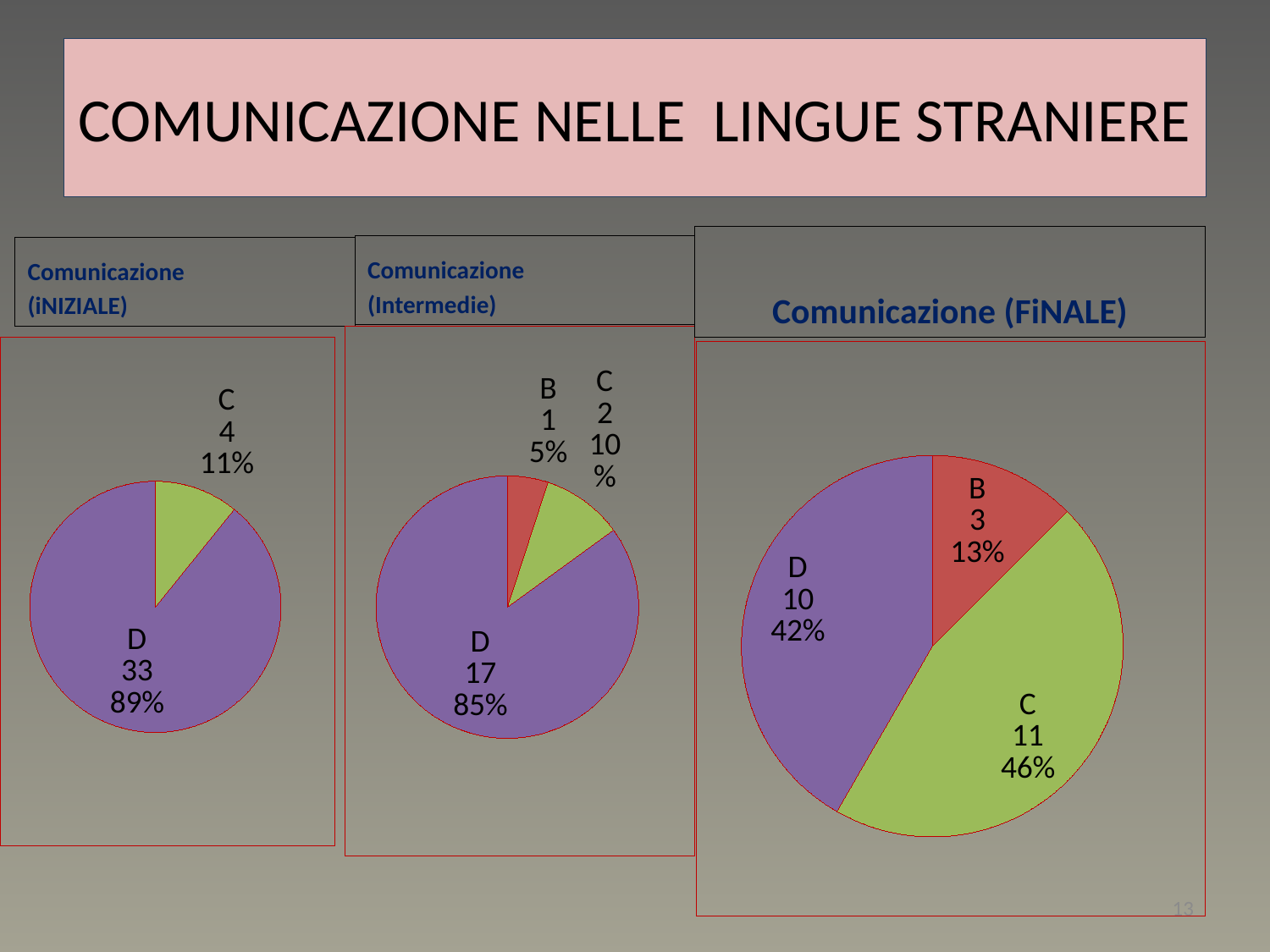
What kind of chart is the Comunicazione (FiNALE) chart? Pie chart In the Comunicazione (FiNALE) chart, which category has the largest slice? C In the Comunicazione (Intermedie) chart, what share of the pie does D have? 85% In the Comunicazione (Intermedie) chart, which category has the smallest slice? B In the Comunicazione (Intermedie) chart, what is the value for B? 1 How many categories are shown in the Comunicazione (Intermedie) chart? 3 In the Comunicazione (iNIZIALE) chart, what share of the pie does C have? 11% In the Comunicazione (FiNALE) chart, what is the value for C? 11 In the Comunicazione (FiNALE) chart, what is the difference between the values for C and D? 1 In the Comunicazione (iNIZIALE) chart, what is the value for D? 33 In the Comunicazione (FiNALE) chart, what share of the pie does B have? 13% In the Comunicazione (iNIZIALE) chart, which is larger, the value for C or the value for D? D